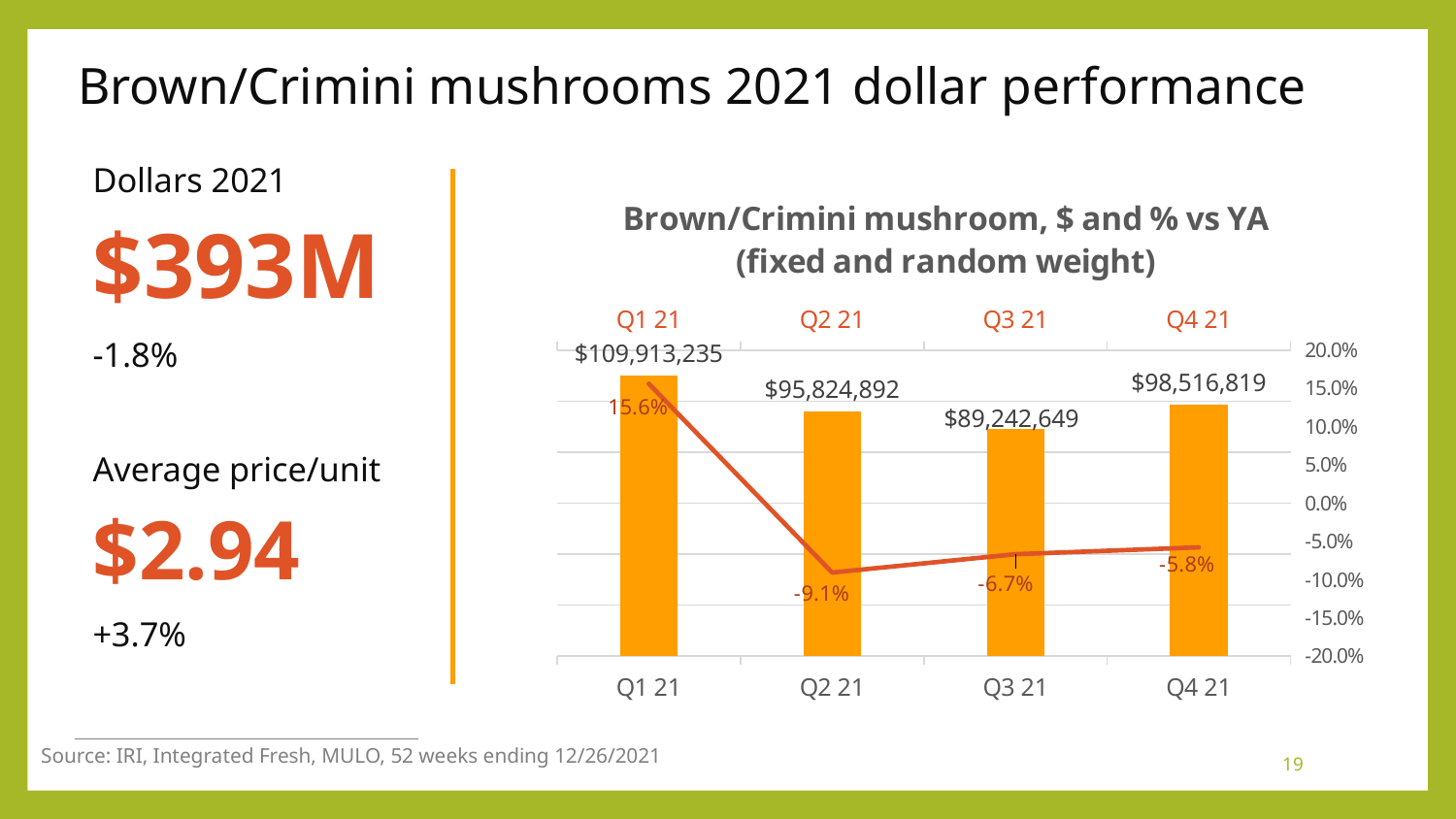
What is the dollar value for Q1 21? $109,913,235 Which quarter has the highest dollar value? Q1 21 Which quarter has the lowest dollar value? Q3 21 What is the title of the chart? Brown/Crimini mushroom, $ and % vs YA (fixed and random weight) Which quarter has the lowest % vs YA value? Q2 21 Which is larger, the dollar value for Q2 21 or Q4 21? Q4 21 What is the % vs YA value for Q2 21? -9.1% What is the difference in dollar value between Q4 21 and Q3 21? $9,274,170 What kind of chart is this? Bar chart with a line What is the dollar value for Q3 21? $89,242,649 How many quarters are shown on the x axis? 4 What is the % vs YA value for Q4 21? -5.8%